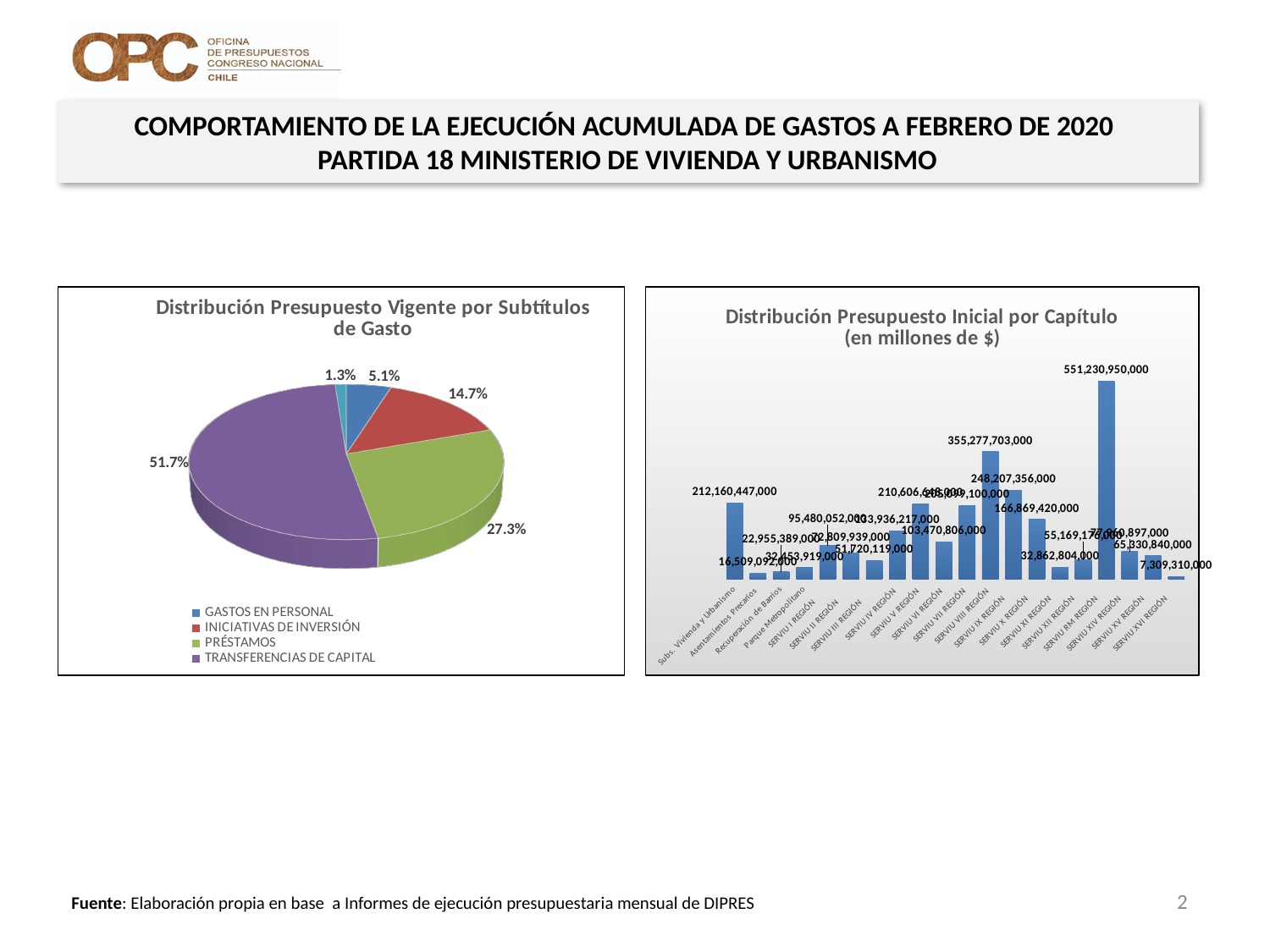
In the 'Distribución Presupuesto Inicial por Capítulo' bar chart, how many categories are shown on the x axis? 20 In the 'Distribución Presupuesto Vigente por Subtítulos de Gasto' pie chart, what share does PRÉSTAMOS have? 27.3% In the 'Distribución Presupuesto Inicial por Capítulo' bar chart, which category has the highest value? SERVIU RM REGIÓN In the 'Distribución Presupuesto Inicial por Capítulo' bar chart, which is larger: SERVIU IX REGIÓN or SERVIU X REGIÓN? SERVIU IX REGIÓN What kind of chart is the 'Distribución Presupuesto Vigente por Subtítulos de Gasto' chart on the left? Pie chart In the 'Distribución Presupuesto Inicial por Capítulo' bar chart, which category has the lowest value? SERVIU XVI REGIÓN In the 'Distribución Presupuesto Inicial por Capítulo' bar chart, what is the value for SERVIU RM REGIÓN? 551,230,950,000 In the 'Distribución Presupuesto Vigente por Subtítulos de Gasto' pie chart, what share does TRANSFERENCIAS DE CAPITAL have? 51.7% In the 'Distribución Presupuesto Inicial por Capítulo' bar chart, what is the value for SERVIU VIII REGIÓN? 355,277,703,000 What kind of chart is the 'Distribución Presupuesto Inicial por Capítulo' chart on the right? Bar chart How many entries does the legend of the 'Distribución Presupuesto Vigente por Subtítulos de Gasto' pie chart list? 4 In the 'Distribución Presupuesto Vigente por Subtítulos de Gasto' pie chart, which category has the largest slice? TRANSFERENCIAS DE CAPITAL